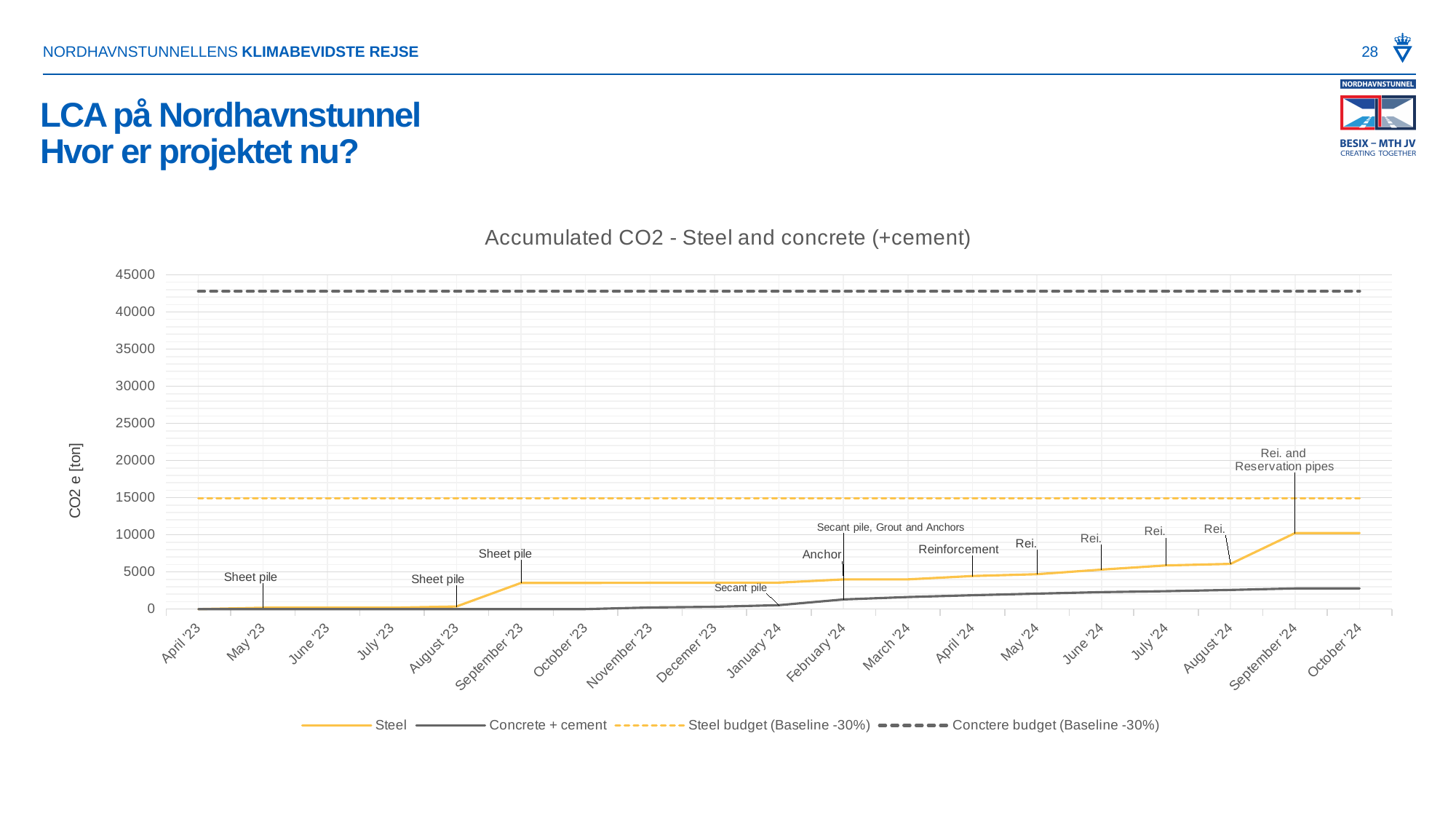
Is the value of the Concrete budget (Baseline -30%) line greater or less than 40000? greater How many series does the chart legend list? 4 What kind of chart is shown on the slide? line chart Is the value of the Concrete budget (Baseline -30%) line greater or less than 45000? less Is the Steel budget (Baseline -30%) line greater or less than 20000? less How many months are shown along the x axis of the chart? 19 What is the label of the y axis? CO2 e [ton] What is the title of the chart? Accumulated CO2 - Steel and concrete (+cement) Does the Steel series rise or fall from April '23 to October '24? rise In October '24, which series is larger: Steel or Concrete + cement? Steel